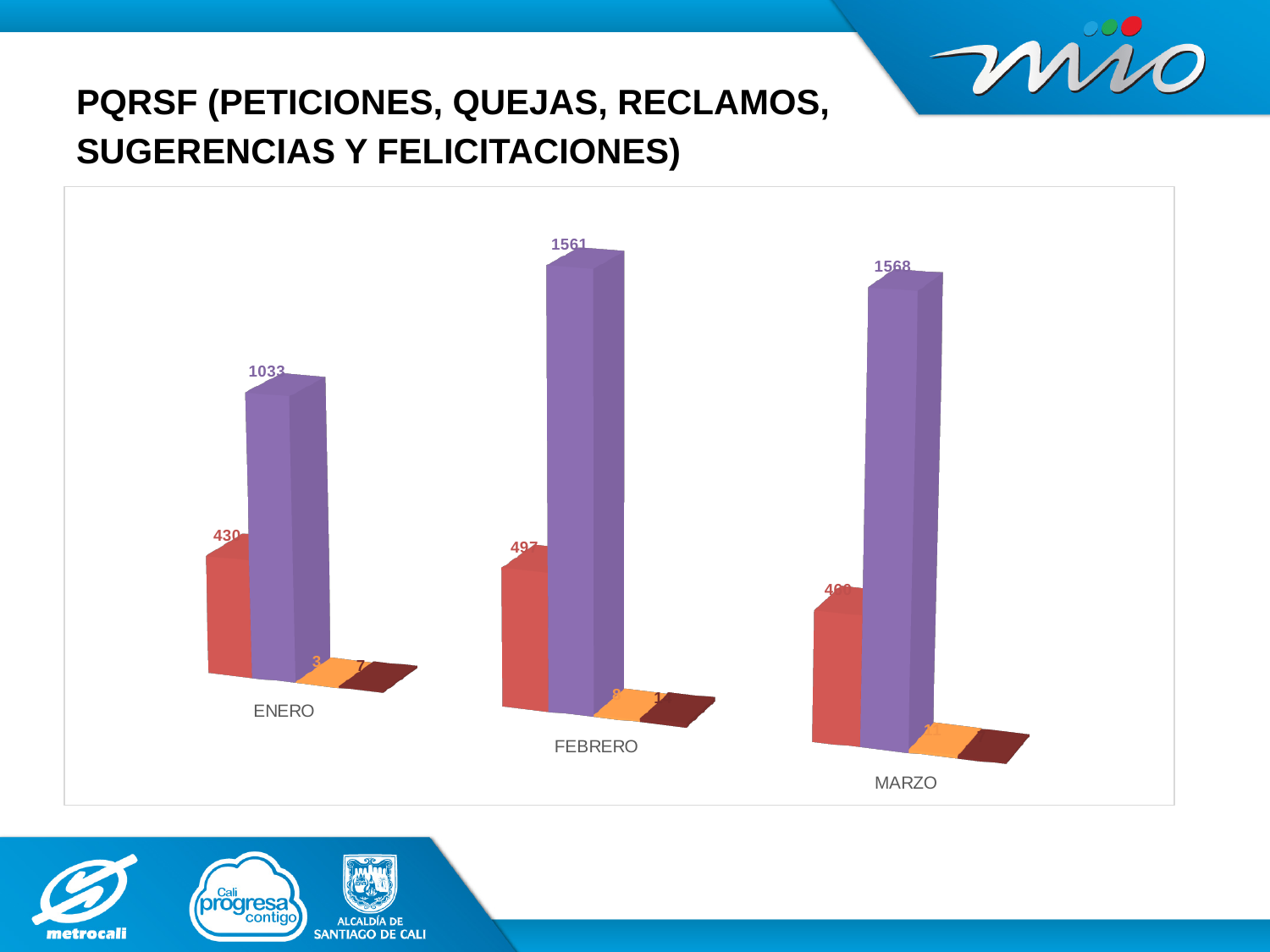
What kind of chart is shown on the slide? bar chart What is the value of the red bar for ENERO? 430 What is the value of the purple bar for MARZO? 1568 Which month has the lowest value for the purple bars? ENERO Which month has the highest value for the purple bars? MARZO What is the value of the purple bar for ENERO? 1033 Do the purple bar values rise or fall from ENERO to MARZO? rise What is the value of the purple bar for FEBRERO? 1561 How many categories (months) are shown on the x axis of the chart? 3 What is the difference between the purple bar values for FEBRERO and ENERO? 528 What is the difference between the red bar values for FEBRERO and ENERO? 67 What is the value of the red bar for FEBRERO? 497